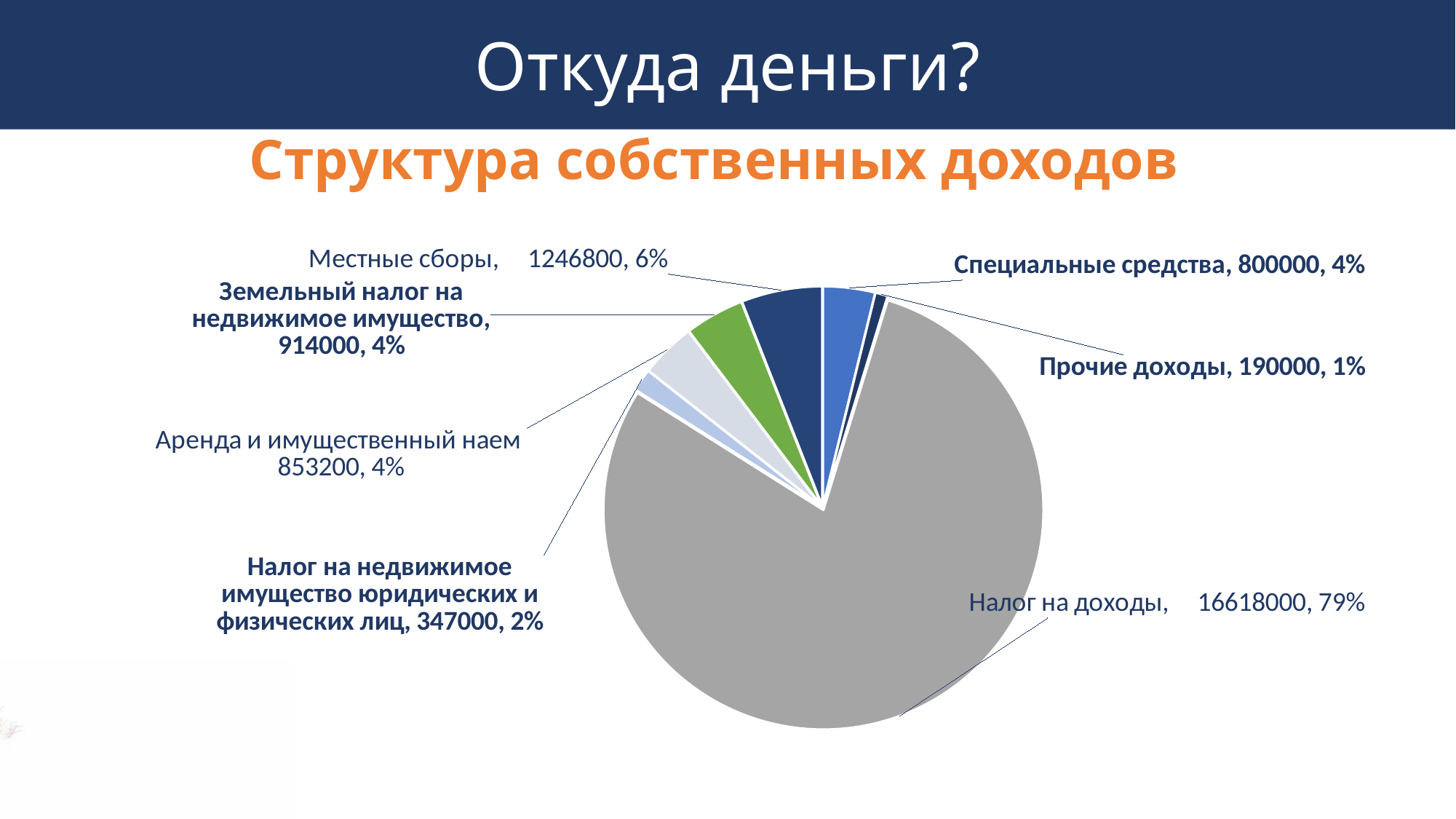
What is the value for Налог на доходы? 16618000 What share of the pie does Прочие доходы represent? 1% Which is larger, the value for Специальные средства or the value for Налог на недвижимое имущество юридических и физических лиц? Специальные средства Which category has the smallest slice of the pie? Прочие доходы What type of chart is shown on the slide? Pie chart What is the difference between the values for Земельный налог на недвижимое имущество and Аренда и имущественный наем? 60800 What is the value for Специальные средства? 800000 What is the title of the chart shown on the slide? Структура собственных доходов What is the value for Местные сборы? 1246800 What share of the pie does Налог на доходы represent? 79% How many categories are shown in the pie chart? 7 Which category has the largest slice of the pie? Налог на доходы